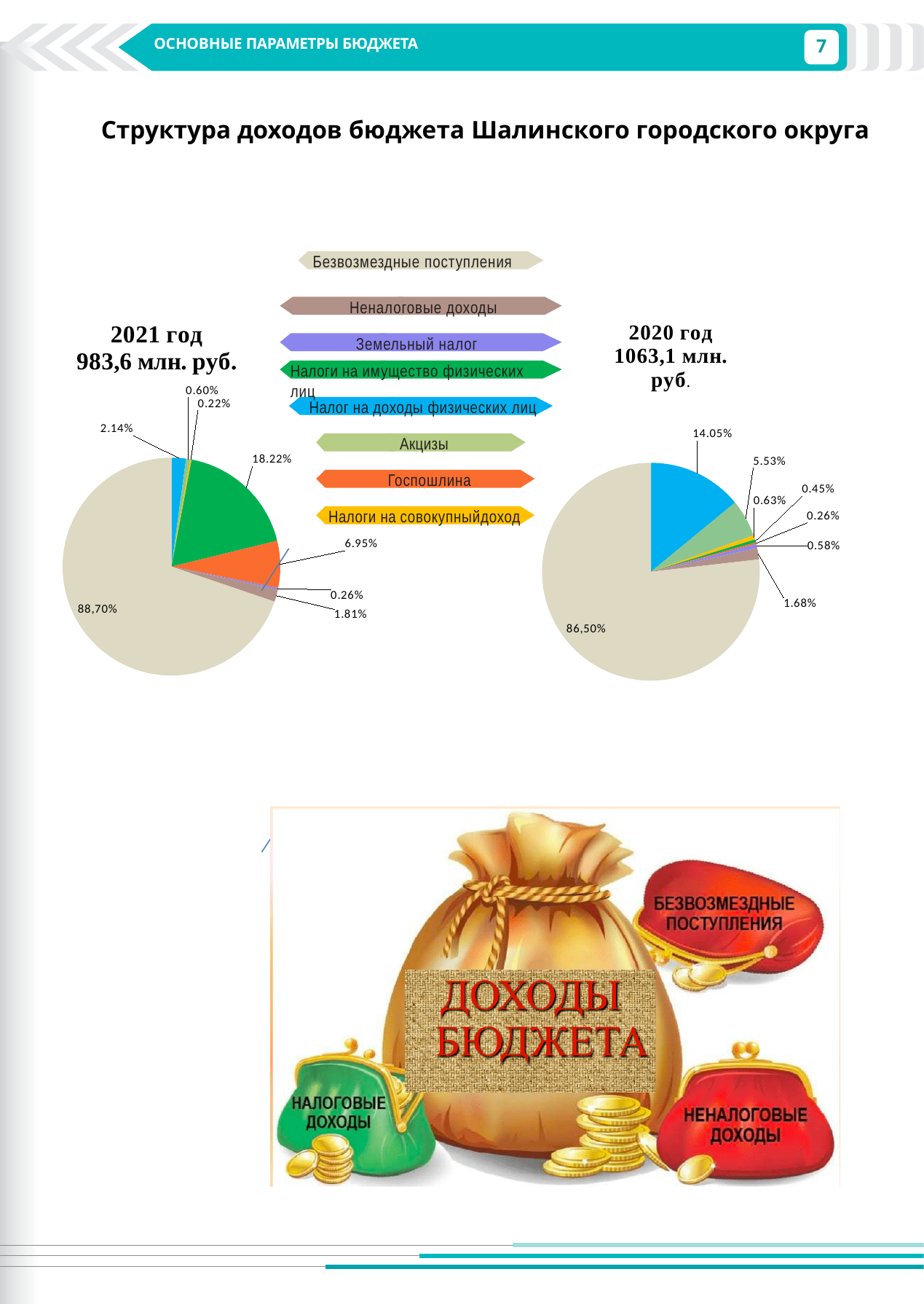
In the 2020 pie chart, what is the value of the largest slice? 86,50% In the 2021 pie chart, what is the smallest labelled slice value? 0.22% Which year's pie chart has the larger biggest slice, 2021 or 2020? 2021 What total revenue amount is shown above the 2020 pie chart? 1063,1 млн. руб. In the 2021 pie chart, what is the value of the largest slice? 88,70% How many entries does the shared legend between the two pie charts list? 8 What total revenue amount is shown above the 2021 pie chart? 983,6 млн. руб. What kind of charts are shown on the slide for 2021 and 2020? Pie charts How many labelled slices does the 2021 pie chart have? 8 In the 2020 pie chart, what is the value of the second-largest slice? 14.05% What is the difference between the largest slice in 2021 (88,70%) and the largest slice in 2020 (86,50%)? 2,20% In the 2020 pie chart, what is the smallest labelled slice value? 0.26%